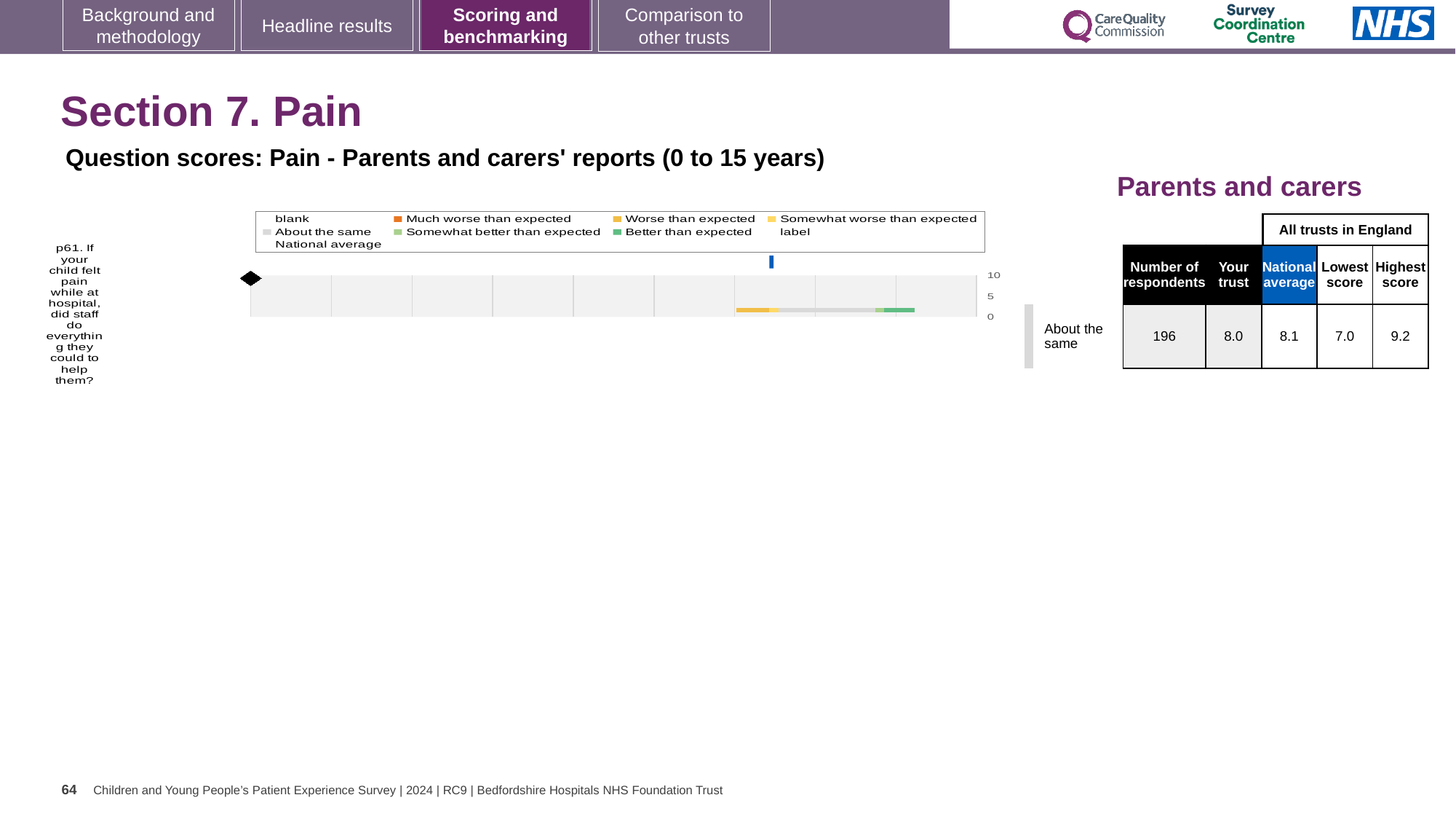
What is the highest score among all trusts in England for question p61? 9.2 How many respondents answered question p61? 196 What is the lowest score among all trusts in England for question p61? 7.0 What kind of chart is shown for question p61? bar chart What is the national average score for question p61? 8.1 How many survey questions are plotted in the chart? 1 Which is larger for question p61: the trust's score or the national average? National average What is the difference between the highest and lowest trust scores for question p61? 2.2 What is the highest value shown on the chart's score axis? 10 How many entries does the chart legend list? 9 What is the trust's score for question p61 (If your child felt pain while at hospital, did staff do everything they could to help them?)? 8.0 Which benchmark category is the trust's result for question p61 placed in? About the same